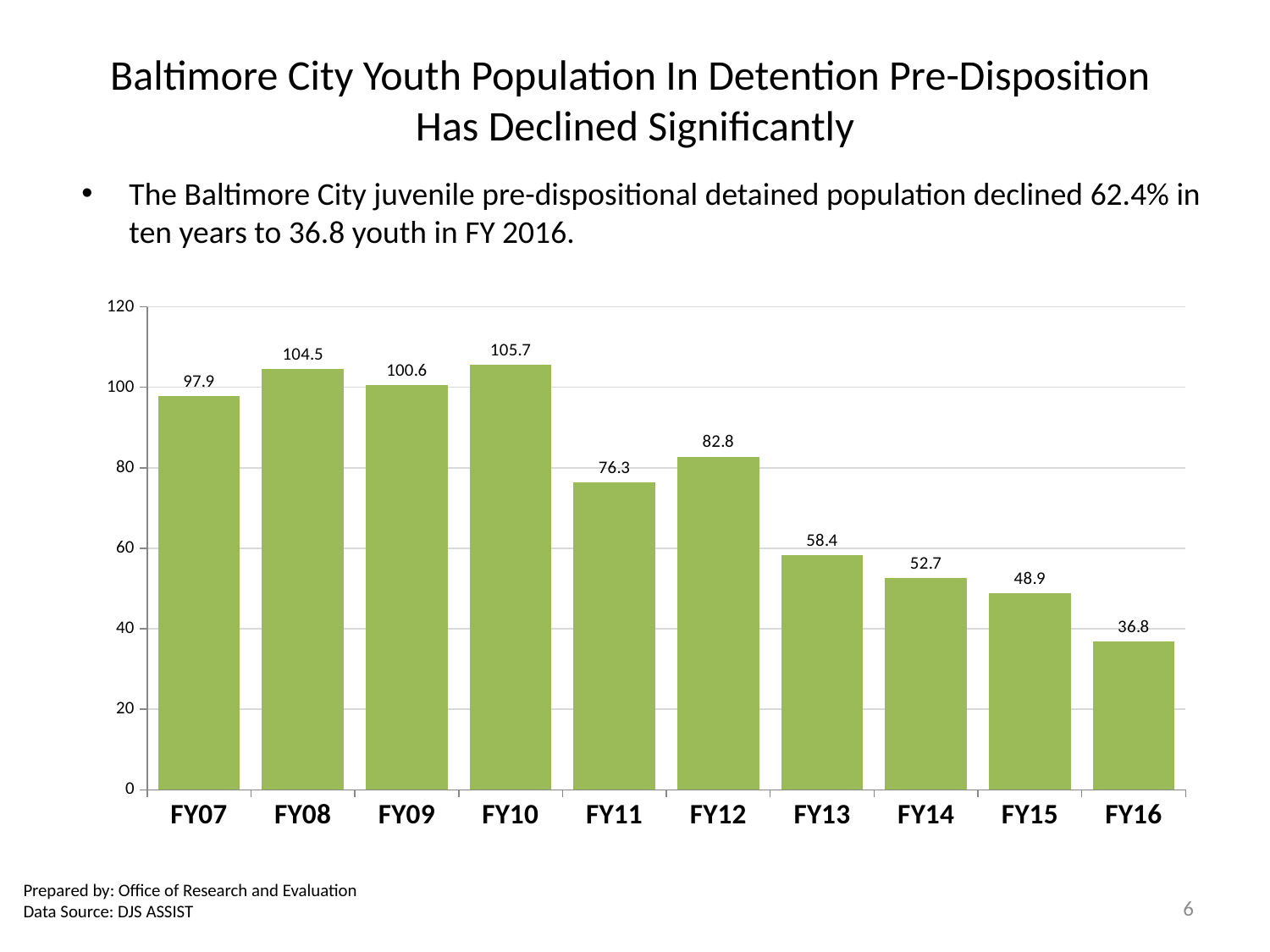
Which is larger, the value for FY08 or the value for FY09? FY08 Which fiscal year has the highest value? FY10 How many fiscal years are shown on the x axis? 10 What is the value for FY16? 36.8 What is the difference between the values for FY10 and FY16? 68.9 Is the value for FY13 greater or less than 60? less What is the difference between the values for FY11 and FY12? 6.5 What is the value for FY07? 97.9 What is the value for FY12? 82.8 Which fiscal year has the lowest value? FY16 What kind of chart is shown on the slide? bar chart Do the values generally rise or fall from FY10 to FY16? fall